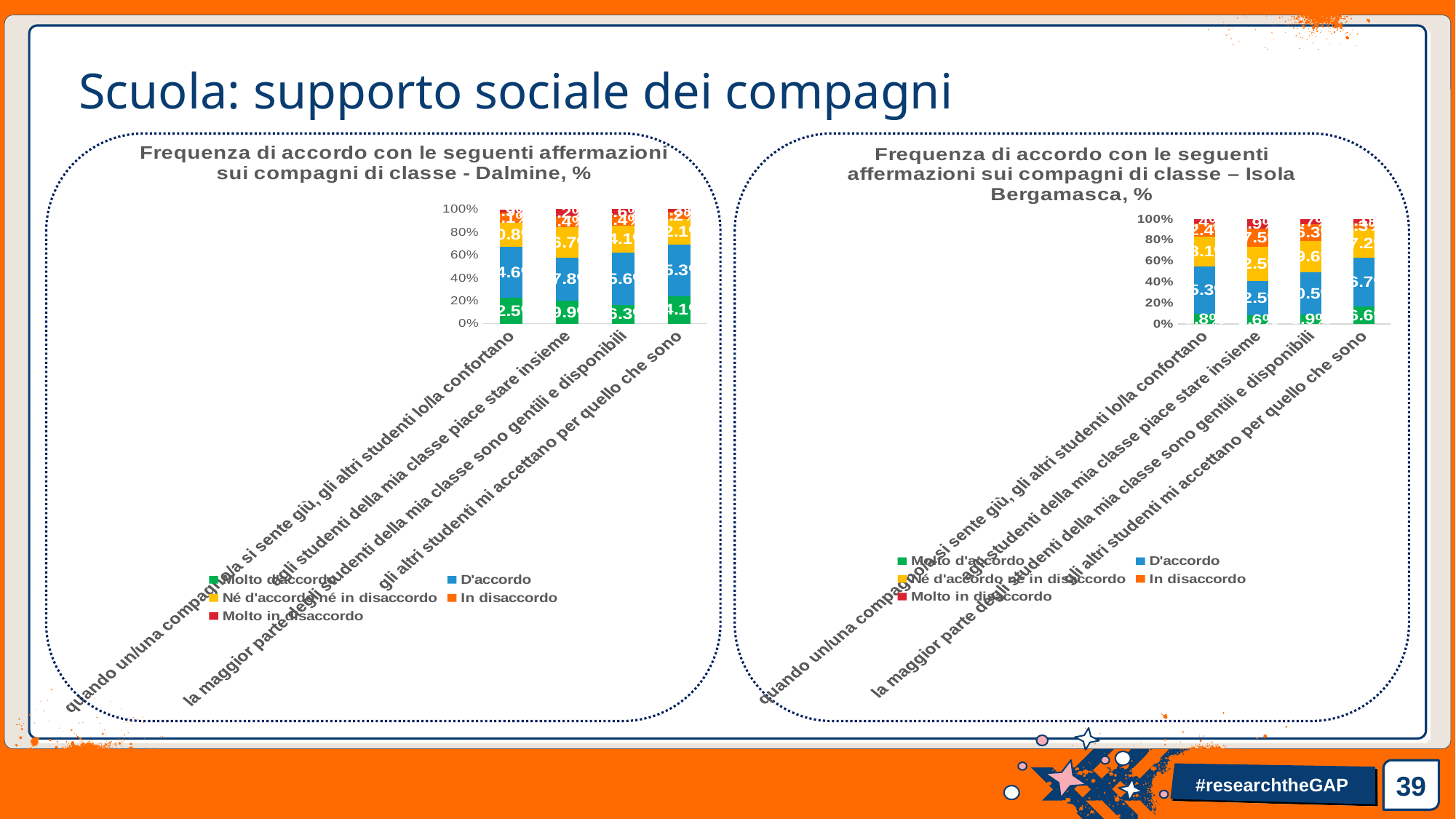
In the right chart (Isola Bergamasca), which series is shown in green according to the legend? Molto d'accordo What kind of chart is the left chart titled 'Frequenza di accordo con le seguenti affermazioni sui compagni di classe - Dalmine, %'? Stacked bar chart In the left chart (Dalmine), is the 'Molto d'accordo' segment for 'quando un/una compagno/a si sente giù, gli altri studenti lo/la confortano' greater or less than 40%? less What kind of chart is the right chart about Isola Bergamasca? Stacked bar chart In the right chart (Isola Bergamasca), is the 'Molto d'accordo' segment for 'gli altri studenti mi accettano per quello che sono' greater or less than 20%? less How many series does the legend of the right chart (Isola Bergamasca) list? 5 In the left chart (Dalmine), how many categories (statements) are shown on the x axis? 4 In the right chart (Isola Bergamasca), is the 'Molto d'accordo' segment for 'la maggior parte degli studenti della mia classe sono gentili e disponibili' greater or less than 20%? less In the right chart (Isola Bergamasca), how many bars are plotted? 4 What is the maximum value shown on the y axis of the left chart (Dalmine)? 100% How many series does the legend of the left chart (Dalmine) list? 5 In the left chart (Dalmine), which series is shown in blue according to the legend? D'accordo